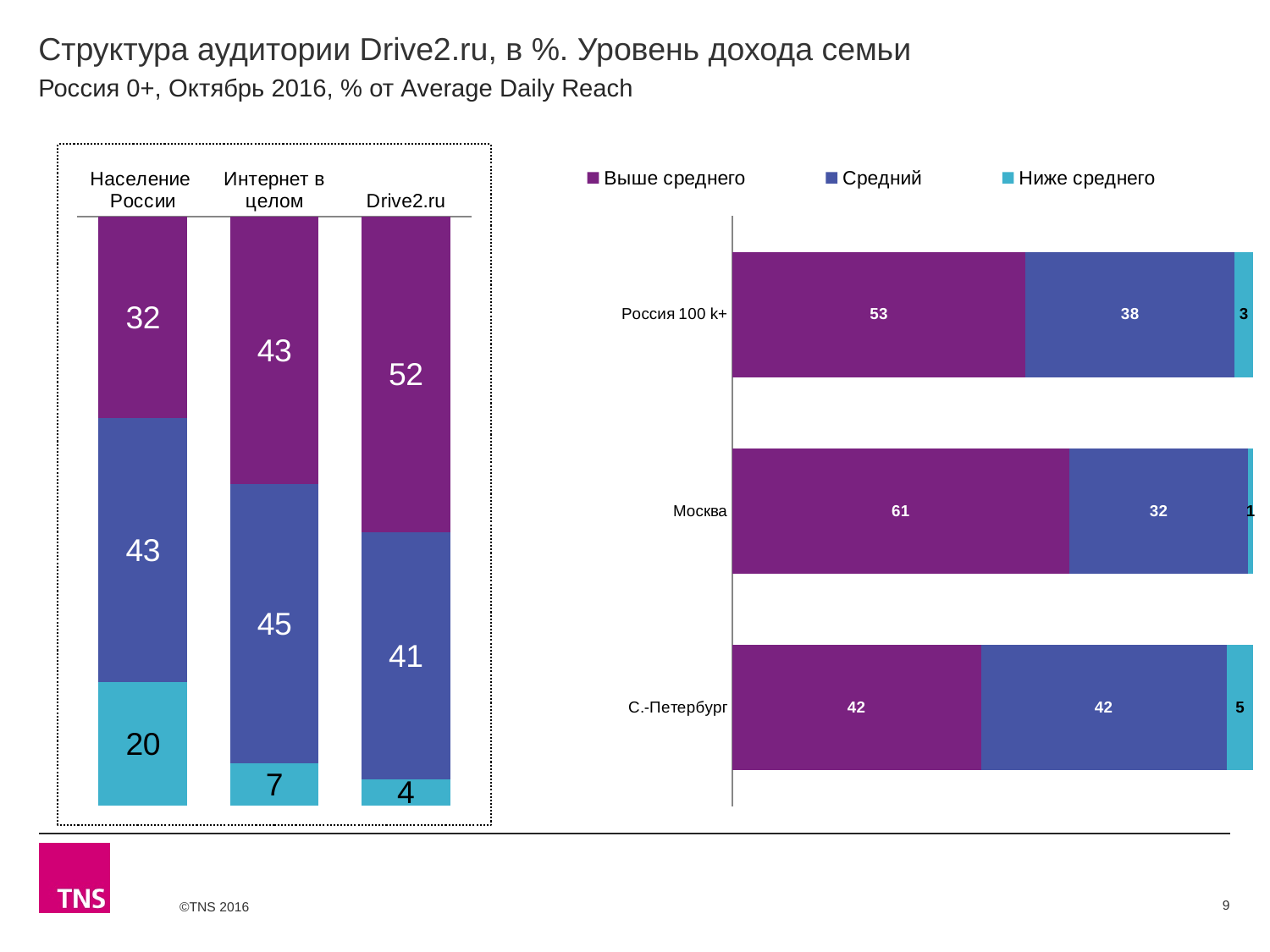
In the right chart, which category has the highest value for Выше среднего? Москва In the left chart, how many categories are shown? 3 In the right chart, how many series does the legend list? 3 In the left chart, which category has the smallest bottom segment? Drive2.ru In the right chart, is the Средний value for Россия 100 k+ larger or smaller than the Средний value for Москва? larger In the left chart, what is the value of the middle segment for Интернет в целом? 45 In the right chart, what is the value of Ниже среднего for С.-Петербург? 5 In the right chart, what is the value of Выше среднего for Москва? 61 In the left chart, what is the value of the top segment for Drive2.ru? 52 In the left chart, what is the difference between the top segment of Drive2.ru and the top segment of Население России? 20 What type of chart is the right chart? Stacked bar chart In the left chart, what is the value of the bottom segment for Население России? 20